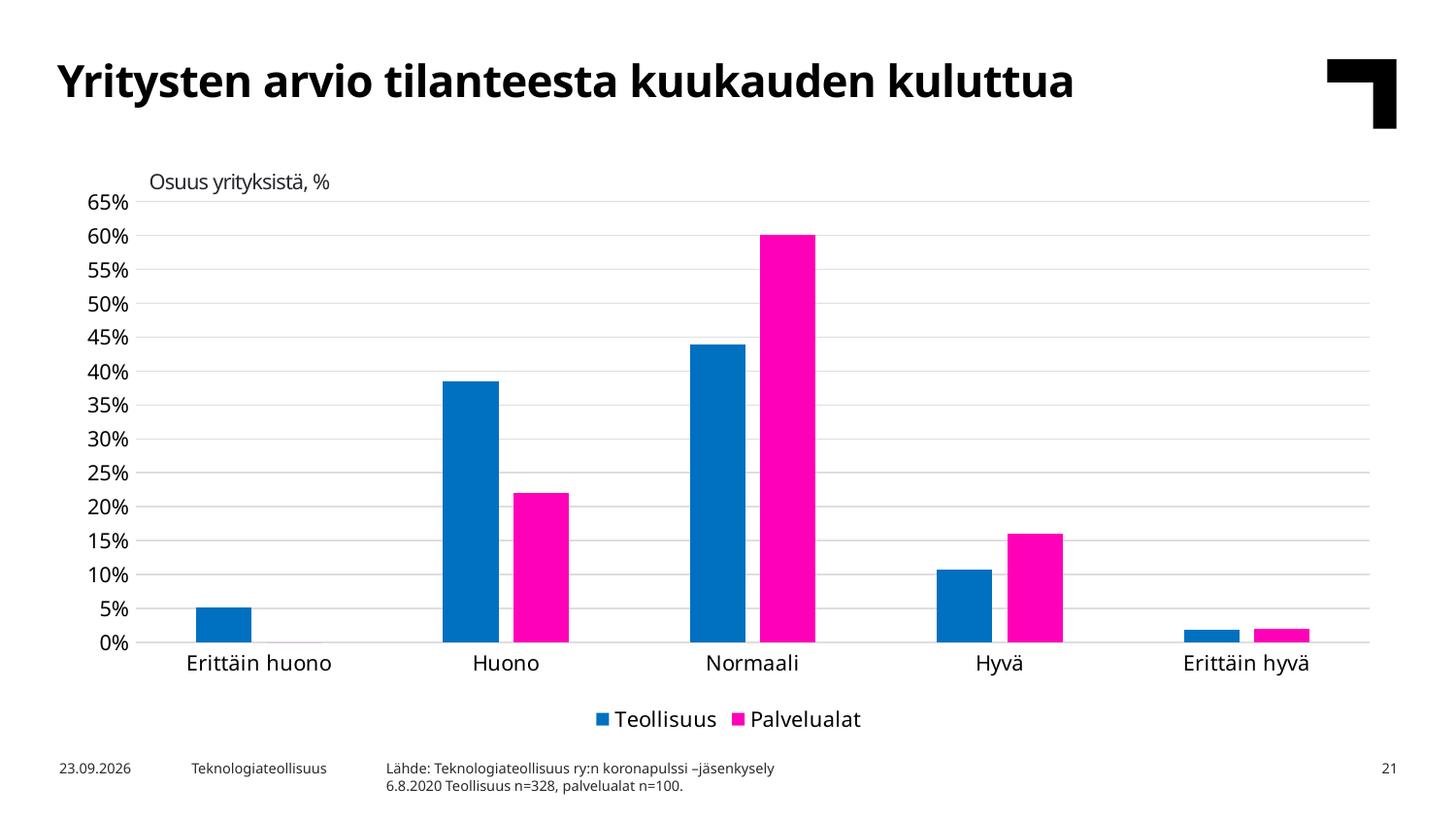
How many categories are shown on the x axis? 5 How many series does the legend list? 2 What kind of chart is shown on the slide? Bar chart For the category Huono, which series has the larger value, Teollisuus or Palvelualat? Teollisuus Which category has the highest value for Palvelualat? Normaali Is the value for Teollisuus in the category Huono greater or less than 35%? greater Which colour represents the Palvelualat series in the legend? Magenta (pink) Which category has the lowest value for Palvelualat? Erittäin huono Which category has the highest value for Teollisuus? Normaali For the category Normaali, which series has the larger value, Teollisuus or Palvelualat? Palvelualat Is the value for Palvelualat in the category Hyvä greater or less than 20%? less Is the value for Teollisuus in the category Normaali greater or less than 50%? less